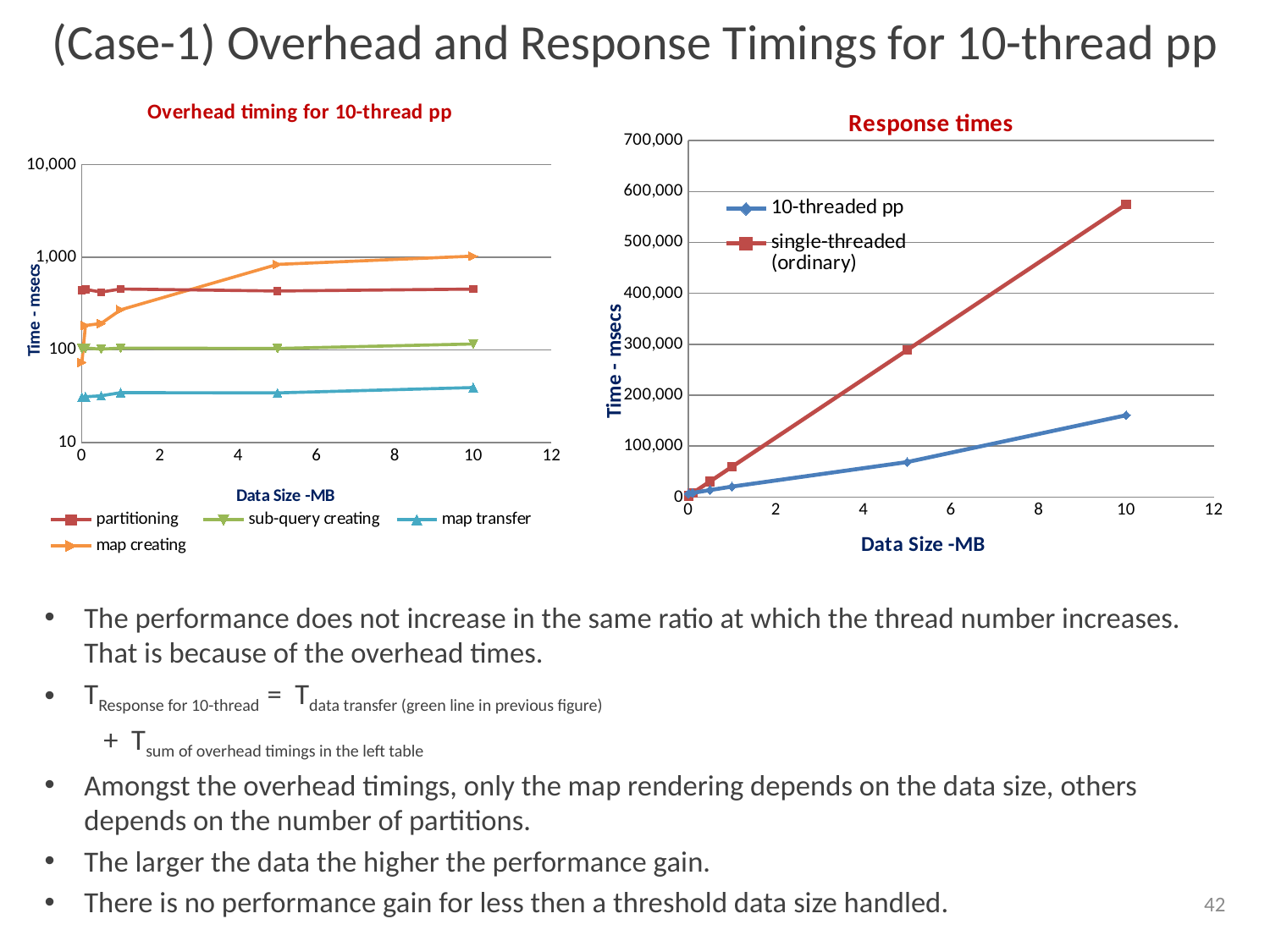
What is the x-axis label of the "Response times" chart? Data Size -MB How many series does the legend of the "Overhead timing for 10-thread pp" chart list? 4 In the "Overhead timing for 10-thread pp" chart, is the value for map transfer at 10 MB greater or less than 100? less How many series does the legend of the "Response times" chart list? 2 In the "Overhead timing for 10-thread pp" chart, which series has the lowest value at 10 MB? map transfer In the "Response times" chart, is the value for 10-threaded pp at 10 MB greater or less than 100,000? greater In the "Response times" chart, which series has the larger value at 10 MB, 10-threaded pp or single-threaded (ordinary)? single-threaded (ordinary) In the "Overhead timing for 10-thread pp" chart, which series has the highest value at 10 MB? map creating In the "Response times" chart, do the single-threaded (ordinary) values rise or fall as data size increases? rise What kind of chart is the "Response times" chart on the right? line chart In the "Response times" chart, is the value for 10-threaded pp at 10 MB greater or less than 200,000? less